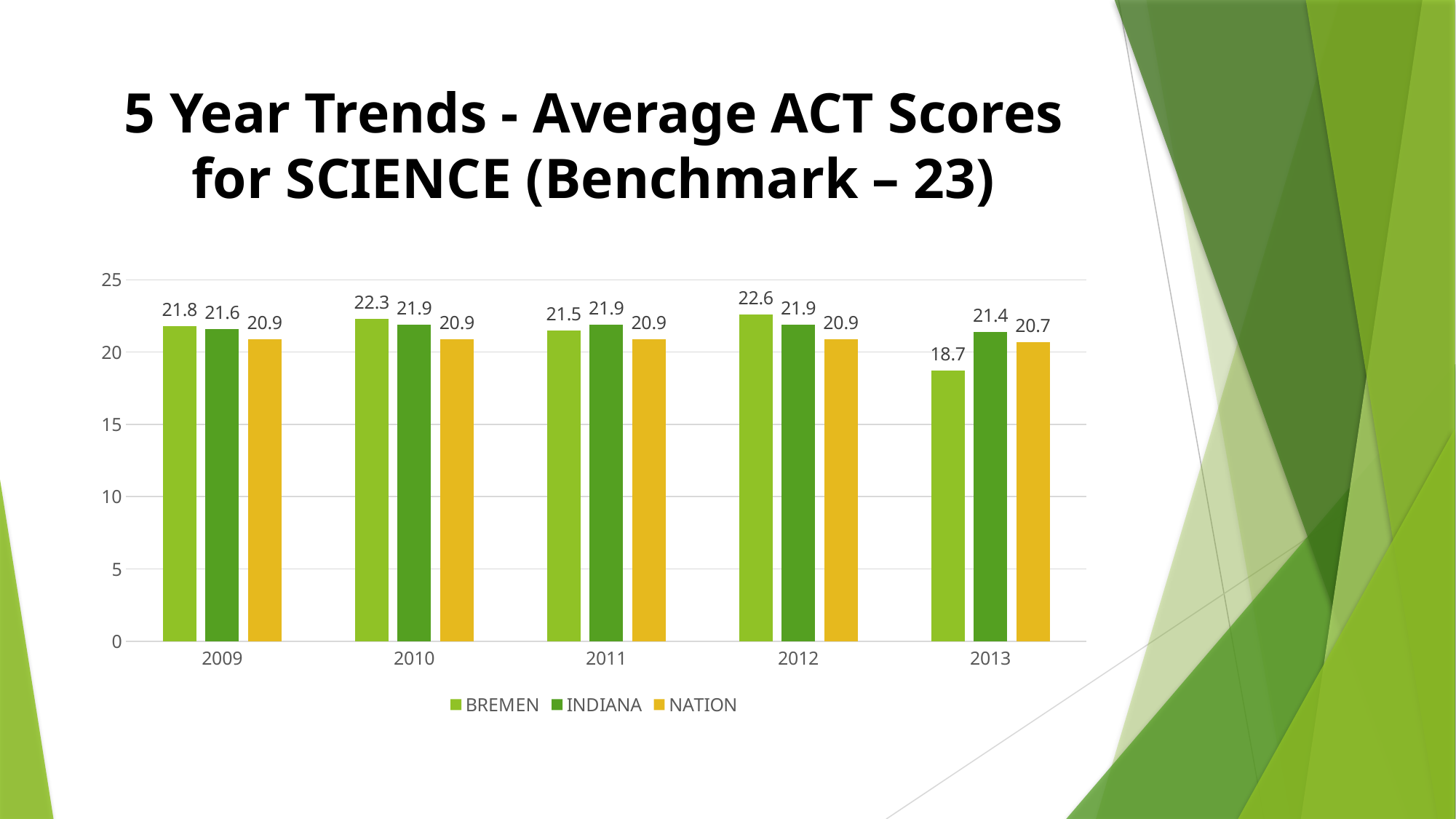
What was the INDIANA average ACT science score in 2009? 21.6 In which year was the BREMEN score the highest? 2012 What was the BREMEN average ACT science score in 2012? 22.6 In 2011, which was higher, the BREMEN score or the INDIANA score? INDIANA What is the difference between the INDIANA and BREMEN scores in 2013? 2.7 What is the difference between the BREMEN and NATION scores in 2012? 1.7 How many years are shown on the x axis? 5 In which year was the BREMEN score the lowest? 2013 Which series is shown in yellow? NATION What was the NATION average ACT science score in 2013? 20.7 What kind of chart is shown on the slide? Bar chart How many series does the legend list? 3